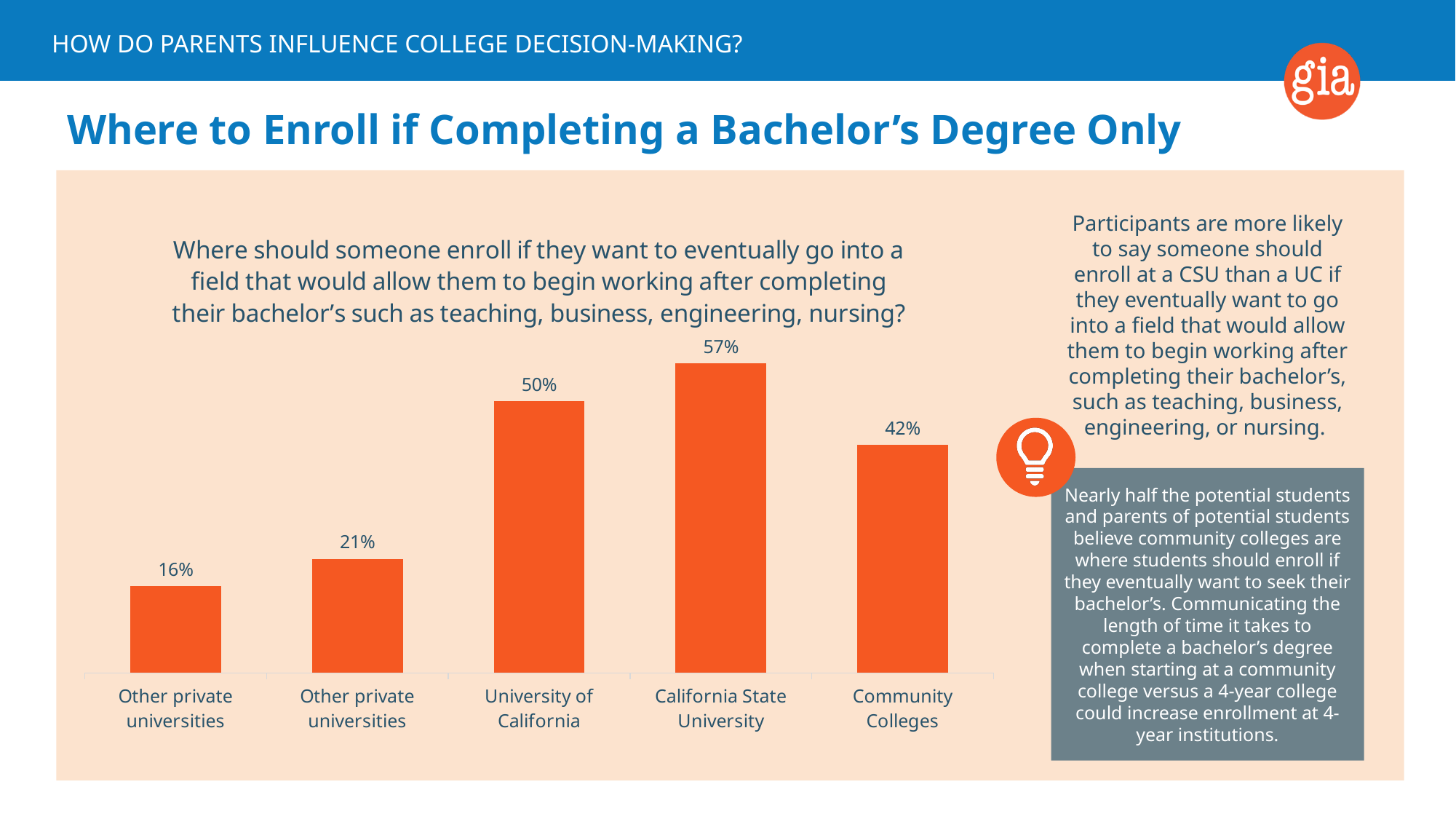
What colour are the bars in the chart? Orange Which is larger, the value for Community Colleges or the value for University of California? University of California Which category has the highest value in the chart? California State University What is the difference between the values for University of California and Community Colleges? 8% What percentage is shown for California State University? 57% What percentage is shown for University of California? 50% What value is shown on the leftmost bar of the chart? 16% What type of chart is shown on the slide? Bar chart What percentage is shown for Community Colleges? 42% What value is shown on the second bar from the left? 21% How many bars are plotted in the chart? 5 What is the difference between the values for California State University and University of California? 7%